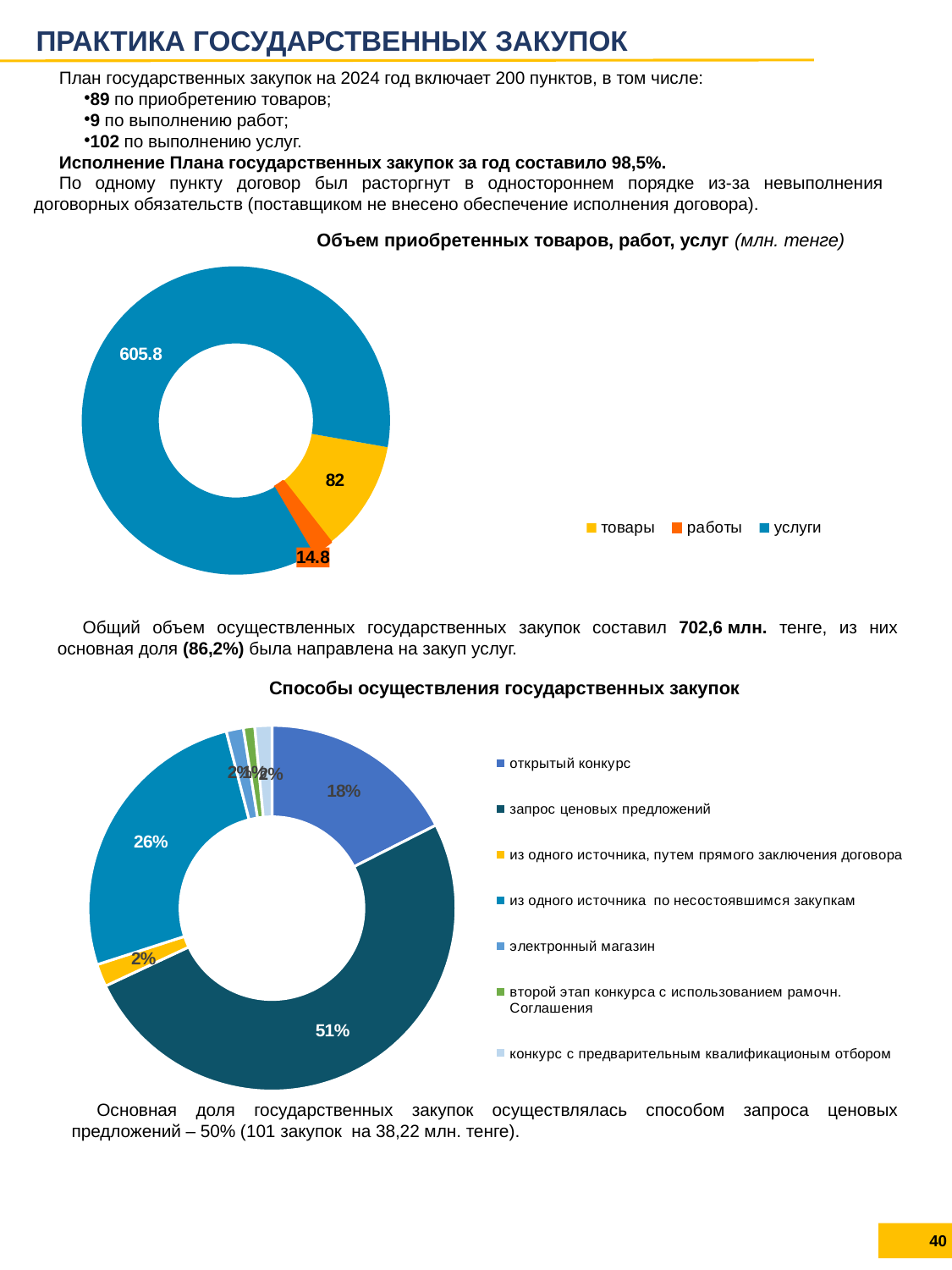
How many entries does the legend of the chart 'Способы осуществления государственных закупок' list? 7 In the chart 'Объем приобретенных товаров, работ, услуг', which category has the smallest value? работы In the chart 'Объем приобретенных товаров, работ, услуг', what is the value for товары? 82 What type of chart is 'Объем приобретенных товаров, работ, услуг'? Doughnut (pie) chart In the chart 'Способы осуществления государственных закупок', what share is из одного источника по несостоявшимся закупкам? 26% In the chart 'Объем приобретенных товаров, работ, услуг', what is the value for работы? 14.8 In the chart 'Объем приобретенных товаров, работ, услуг', what is the difference between услуги and товары? 523.8 In the chart 'Способы осуществления государственных закупок', what share is запрос ценовых предложений? 51% In the chart 'Объем приобретенных товаров, работ, услуг', what is the total of all three segments? 702.6 In the chart 'Объем приобретенных товаров, работ, услуг', what is the value for услуги? 605.8 In the chart 'Способы осуществления государственных закупок', what share is открытый конкурс? 18% In the chart 'Способы осуществления государственных закупок', which method has the largest share? запрос ценовых предложений